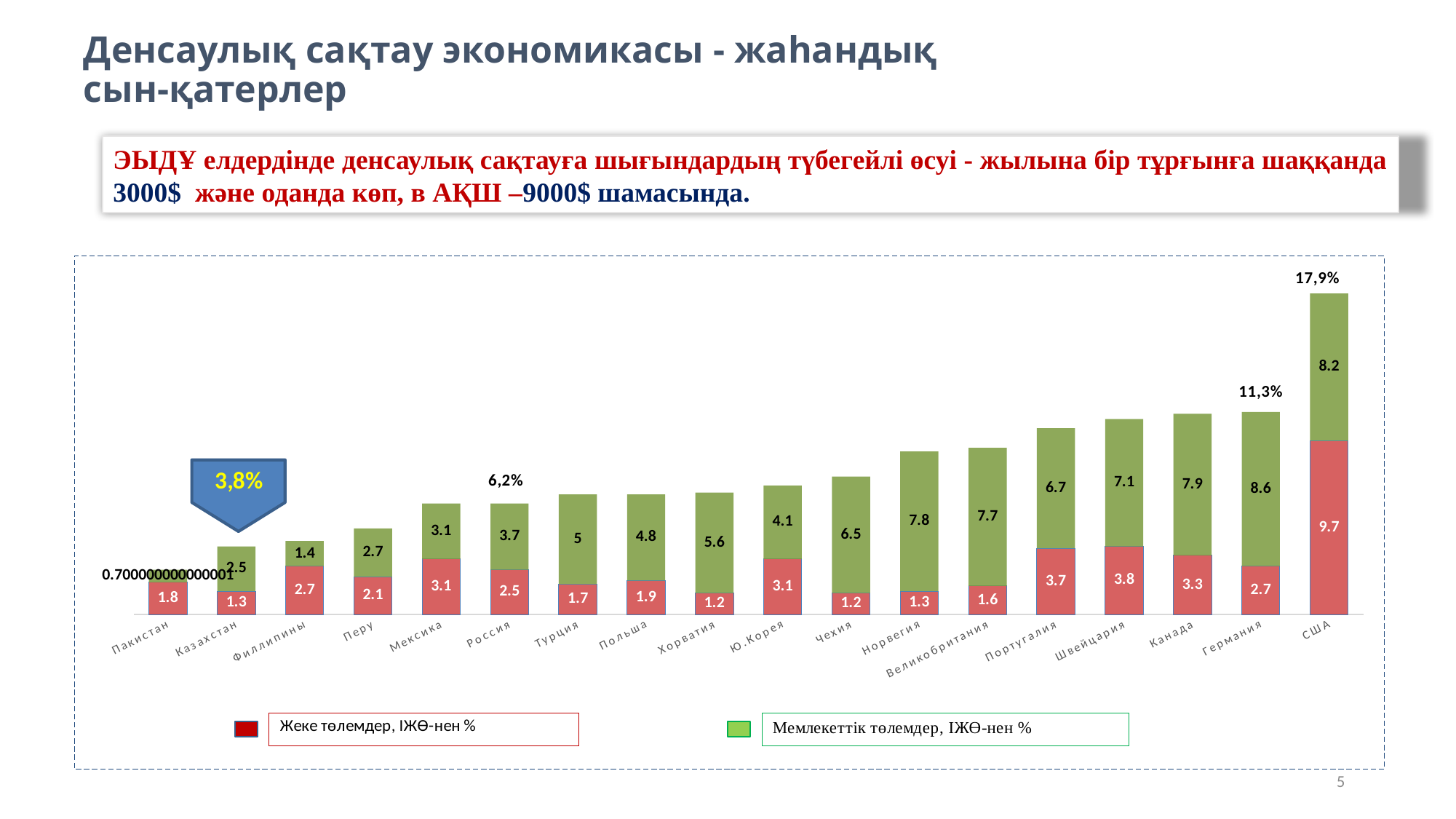
What total percentage is annotated above the bar for Казахстан? 3,8% What kind of chart is shown on the slide? stacked bar chart What is the difference between the Жеке төлемдер values for США and Германия? 7 Which country has the highest total bar in the chart? США Which has a larger Мемлекеттік төлемдер value, Чехия or Норвегия? Норвегия How many countries are shown on the x axis of the chart? 18 What is the value of Жеке төлемдер, ІЖӨ-нен % for Казахстан? 1.3 Which country has the lowest total bar in the chart? Пакистан What is the value of Жеке төлемдер, ІЖӨ-нен % for США? 9.7 What is the value of Мемлекеттік төлемдер, ІЖӨ-нен % for Германия? 8.6 How many series does the chart's legend list? 2 What is the total of the stacked bar for Канада? 11.2